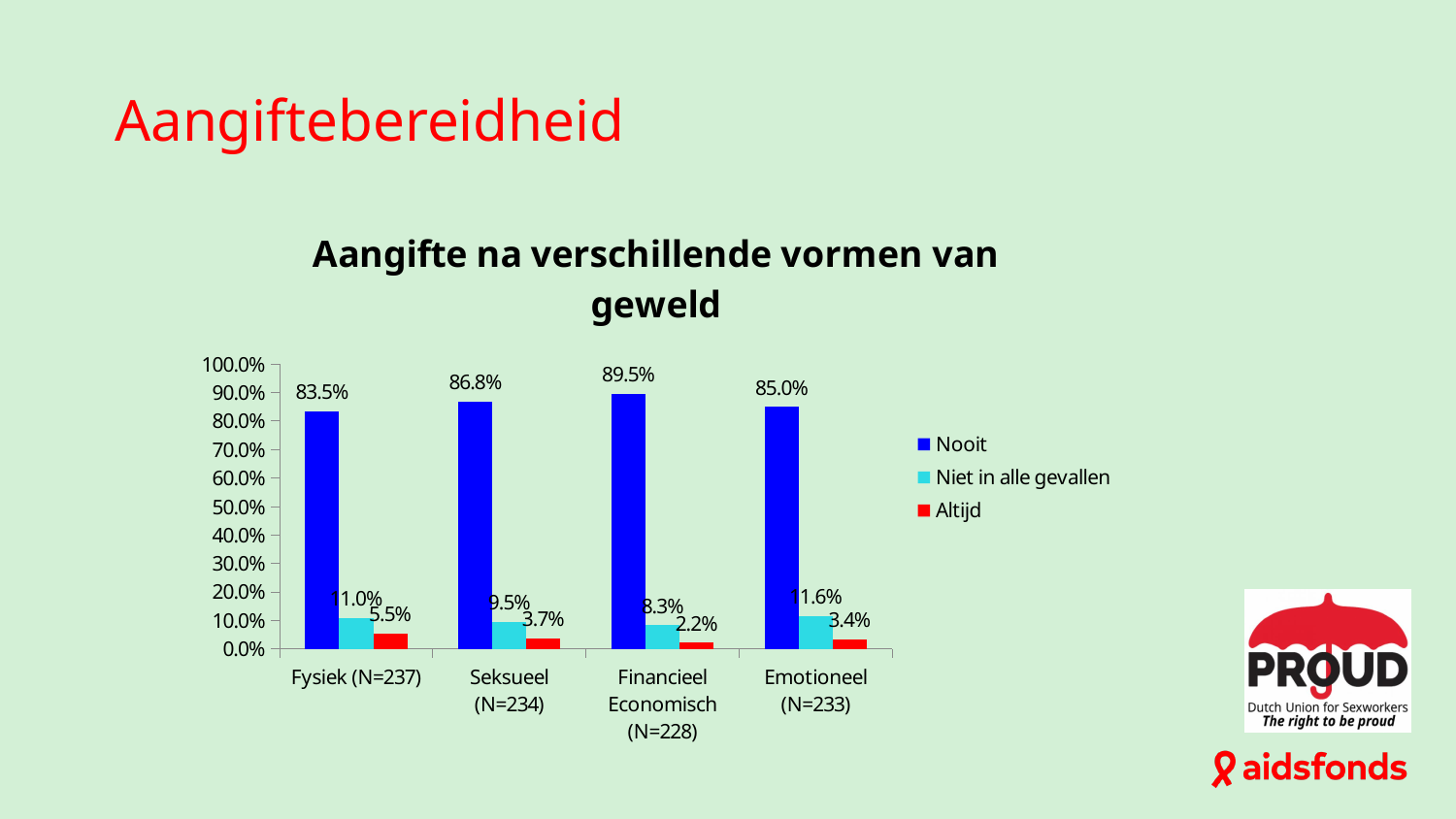
Which is larger: the 'Niet in alle gevallen' value for Fysiek (N=237) or for Seksueel (N=234)? Fysiek (N=237) What is the title of the chart? Aangifte na verschillende vormen van geweld How many series does the legend list? 3 Which category has the lowest value for the 'Altijd' series? Financieel Economisch (N=228) How many categories are shown on the x axis? 4 Which category has the highest value for the 'Nooit' series? Financieel Economisch (N=228) What is the difference between the 'Nooit' values for Seksueel (N=234) and Fysiek (N=237)? 3.3% What is the value of the 'Niet in alle gevallen' series for Emotioneel (N=233)? 11.6% Is the 'Nooit' value for Emotioneel (N=233) greater or less than 80.0%? greater What is the value of the 'Nooit' series for Fysiek (N=237)? 83.5% What kind of chart is shown on the slide? Bar chart What is the value of the 'Altijd' series for Financieel Economisch (N=228)? 2.2%